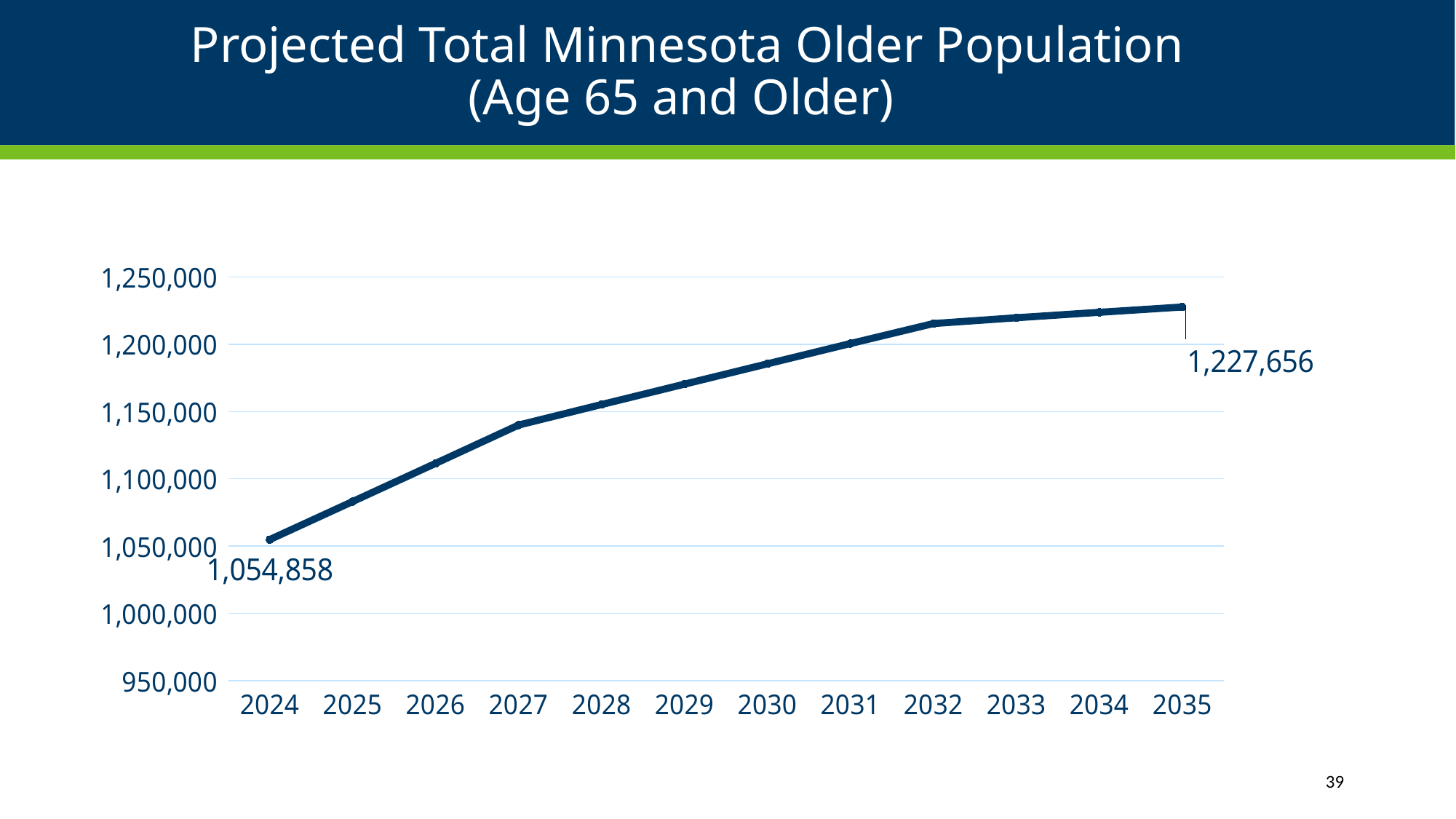
What is the projected population for 2035? 1,227,656 Which year has a larger projected population, 2026 or 2031? 2031 Is the value for 2032 greater or less than 1,200,000? greater What is the difference between the projected population in 2035 and in 2024? 172,798 Is the value for 2030 greater or less than 1,200,000? less Which year has the highest projected population? 2035 What is the projected population for 2024? 1,054,858 What kind of chart is shown on the slide? line chart Which year has the lowest projected population? 2024 Is the value for 2027 greater or less than 1,100,000? greater Does the projected population rise or fall from 2024 to 2035? rise How many years are plotted on the x axis? 12